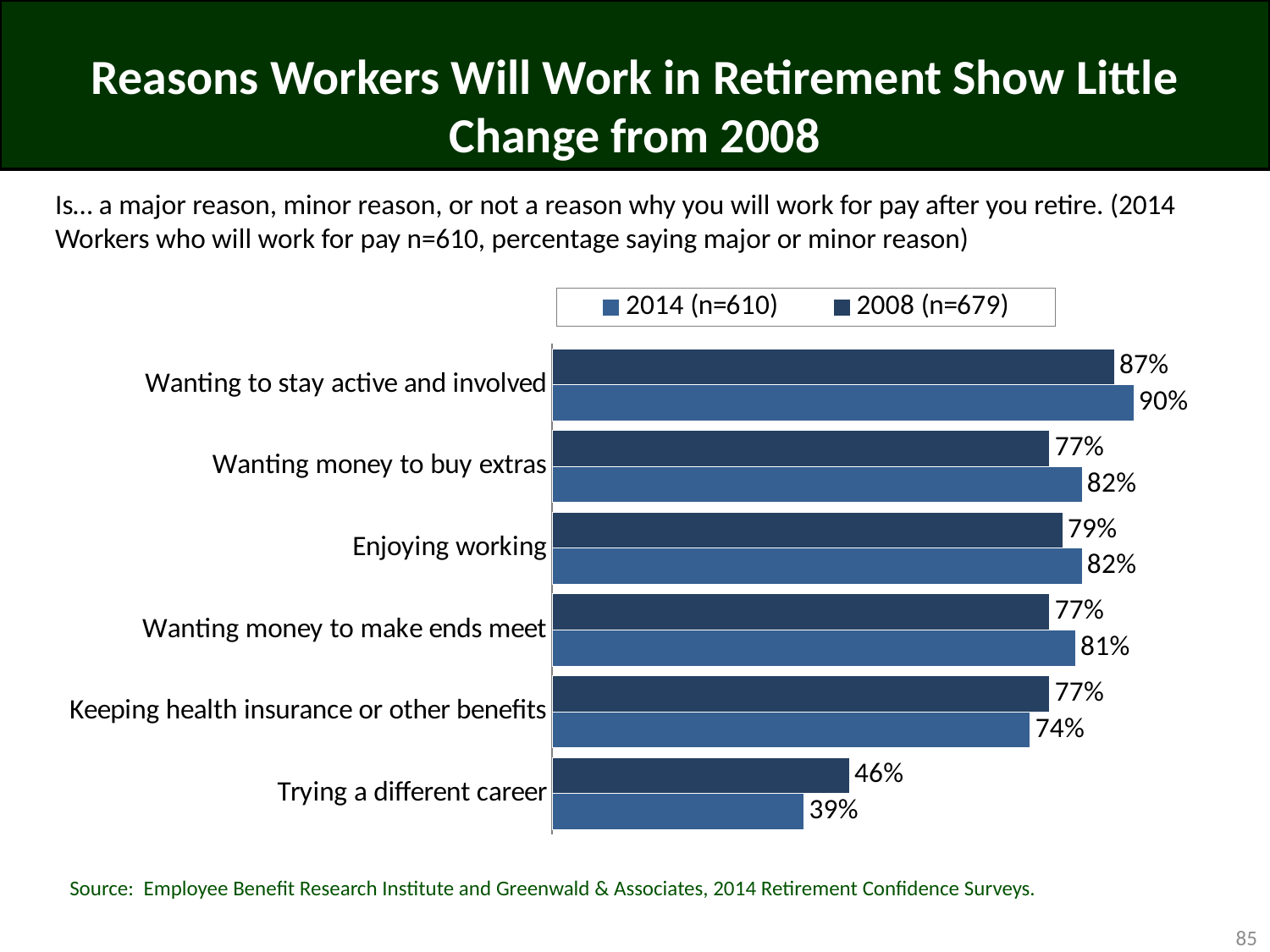
What percentage of 2014 workers cited keeping health insurance or other benefits? 74% How many series does the legend list? 2 For keeping health insurance or other benefits, which year has the larger value, 2014 or 2008? 2008 What was the 2008 value for trying a different career? 46% What is the sample size shown in the legend for the 2008 series? n=679 What percentage of 2014 workers cited wanting to stay active and involved as a reason? 90% What was the 2008 value for enjoying working? 79% How many reasons (categories) are shown in the chart? 6 What is the difference between the 2008 and 2014 values for trying a different career? 7% Which reason has the highest value for the 2014 series? Wanting to stay active and involved What type of chart is shown on the slide? Bar chart Which reason has the lowest value for the 2008 series? Trying a different career